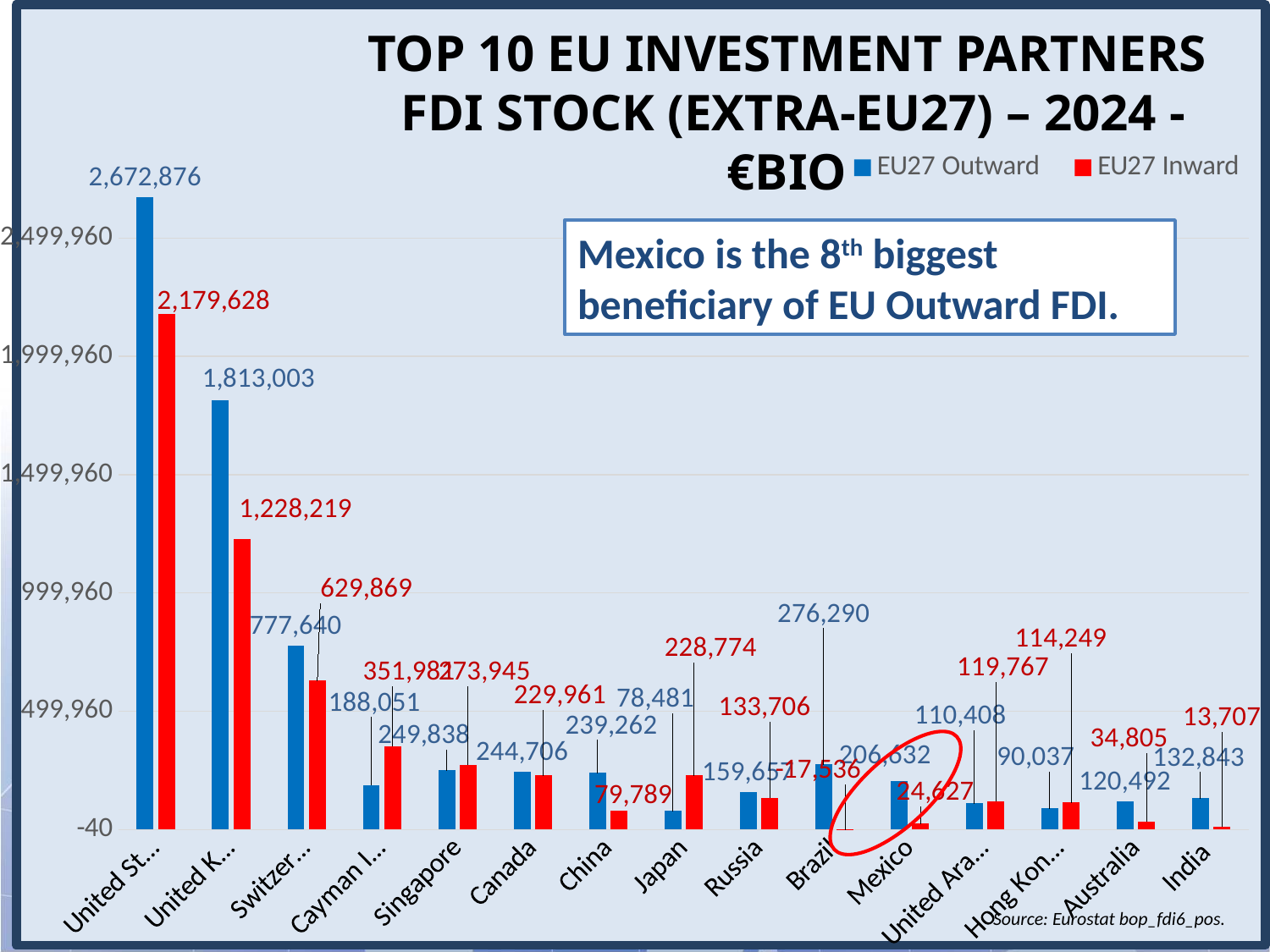
What is the EU27 Outward value for Mexico? 206,632 What is the difference between the EU27 Outward and EU27 Inward values for the United Kingdom? 584,784 What is the EU27 Inward value for Switzerland? 629,869 What is the EU27 Inward value for India? 13,707 Which country has the highest EU27 Outward value? United States What is the EU27 Outward value for the United States? 2,672,876 What are the two series named in the legend? EU27 Outward and EU27 Inward What kind of chart is shown on the slide? Bar chart What is the difference between the EU27 Outward and EU27 Inward values for the United States? 493,248 For Japan, which is larger: the EU27 Outward value or the EU27 Inward value? EU27 Inward How many series does the legend list? 2 How many countries are shown on the x axis? 15